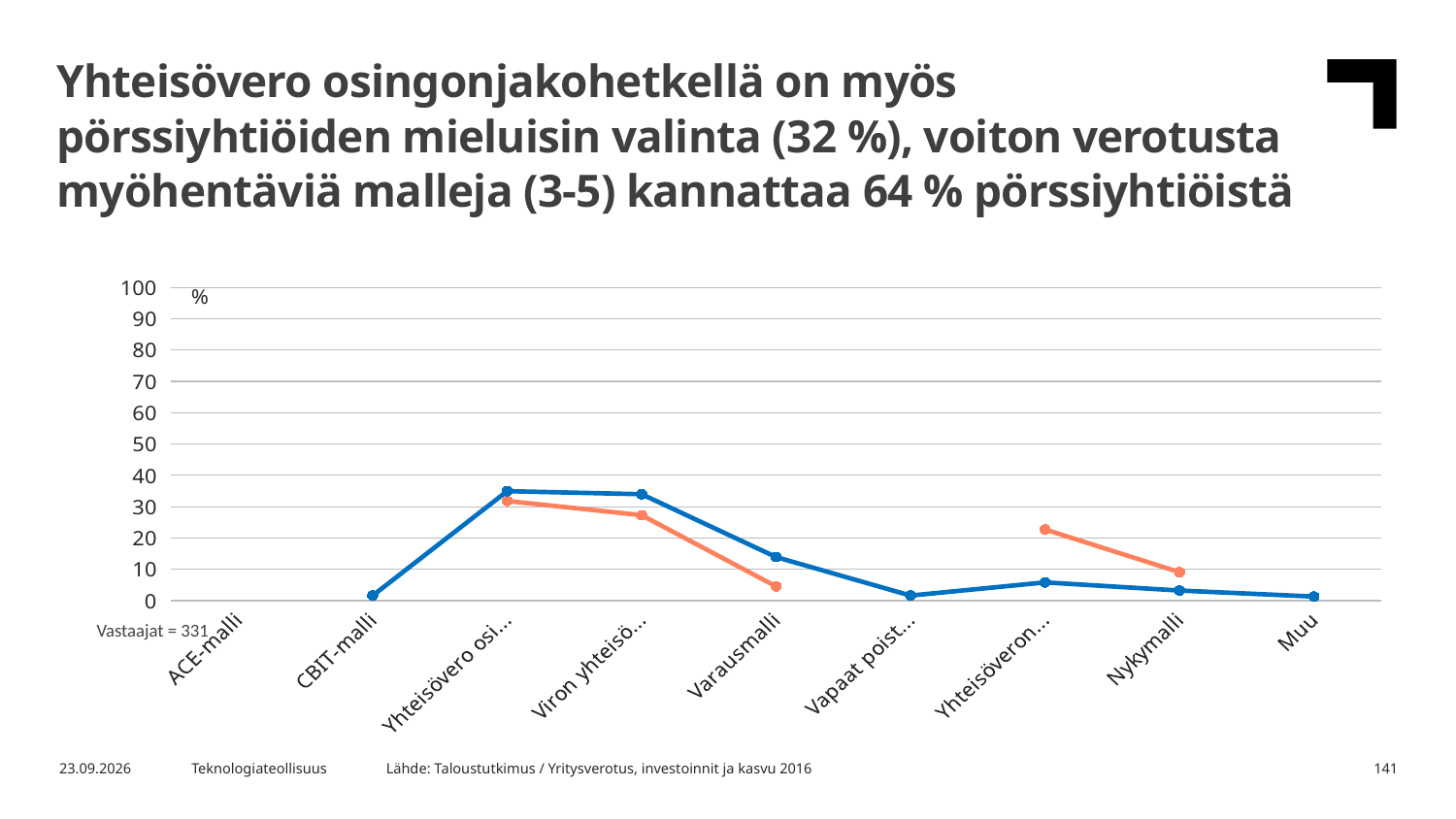
Is the value of the blue line for Varausmalli greater or less than 20? less Is the value of the blue line for Yhteisövero osi... greater or less than 30? greater Which is larger for the blue line: the value for Varausmalli or the value for Nykymalli? Varausmalli Is the value of the orange line for Yhteisöveron... greater or less than 20? greater At which category does the orange line reach its highest value? Yhteisövero osi... What kind of chart is shown on the slide? line chart What unit is shown at the top of the y axis of the chart? % At Varausmalli, which line has the larger value, the blue line or the orange line? the blue line Does the blue line rise or fall from Viron yhteisö... to Vapaat poist...? fall How many categories are shown on the x axis of the chart? 9 At Yhteisöveron..., which line has the larger value, the blue line or the orange line? the orange line